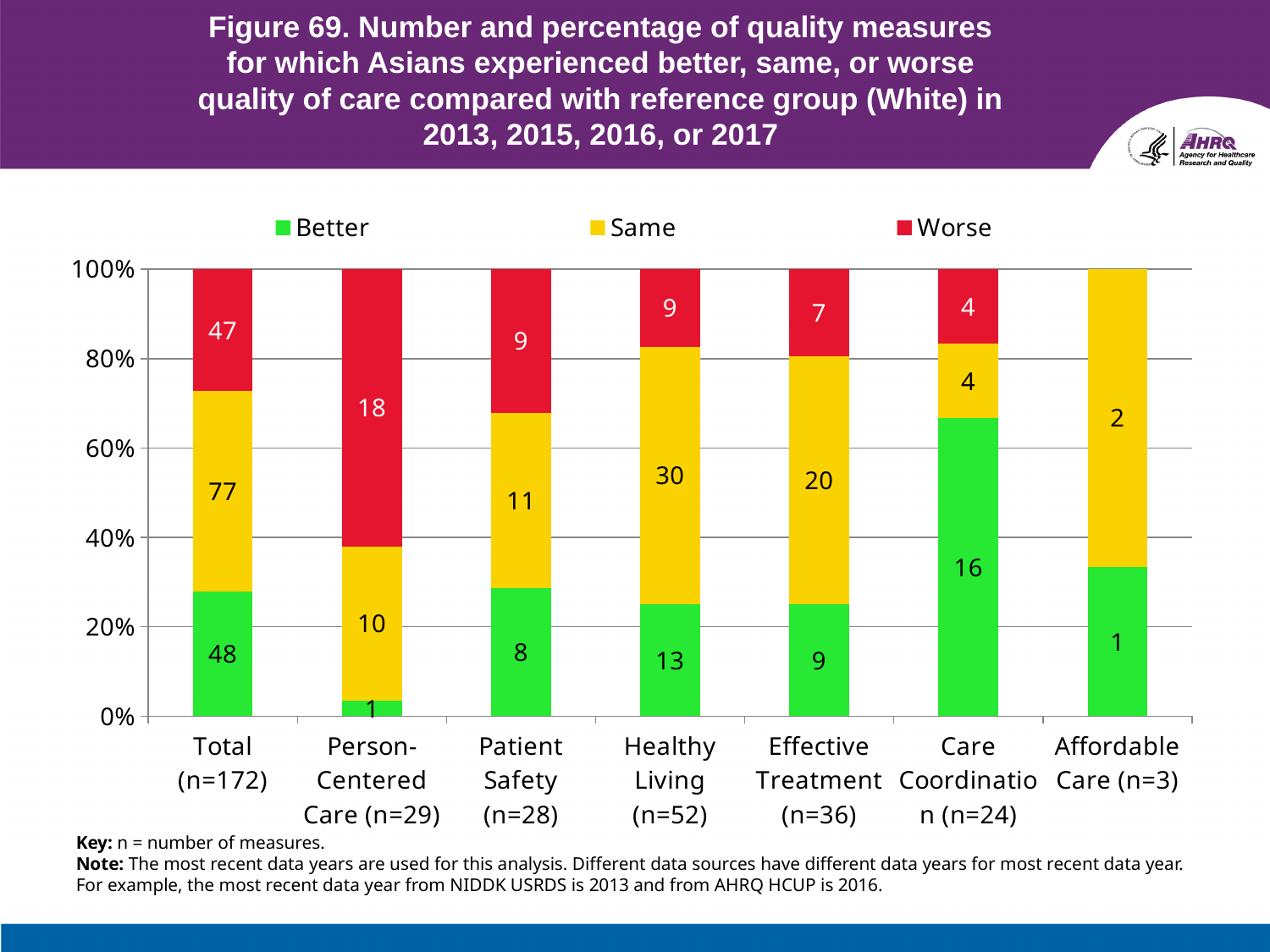
What type of chart is shown on the slide? Stacked bar chart How many series does the legend list? 3 Which is larger for Patient Safety (n=28): the 'Same' count or the 'Worse' count? Same How many categories are shown along the x axis? 7 What is the number of 'Better' measures for Care Coordination (n=24)? 16 What is the number of 'Same' measures for Total (n=172)? 77 Excluding Total, which category has the highest number of 'Same' measures? Healthy Living (n=52) What is the difference between the 'Same' and 'Worse' counts for Effective Treatment (n=36)? 13 What is the total number of measures in the Healthy Living bar (Better + Same + Worse)? 52 What is the number of 'Same' measures for Healthy Living (n=52)? 30 Is the 'Better' share of the Care Coordination (n=24) bar greater or less than 60%? greater What is the number of 'Worse' measures for Person-Centered Care (n=29)? 18